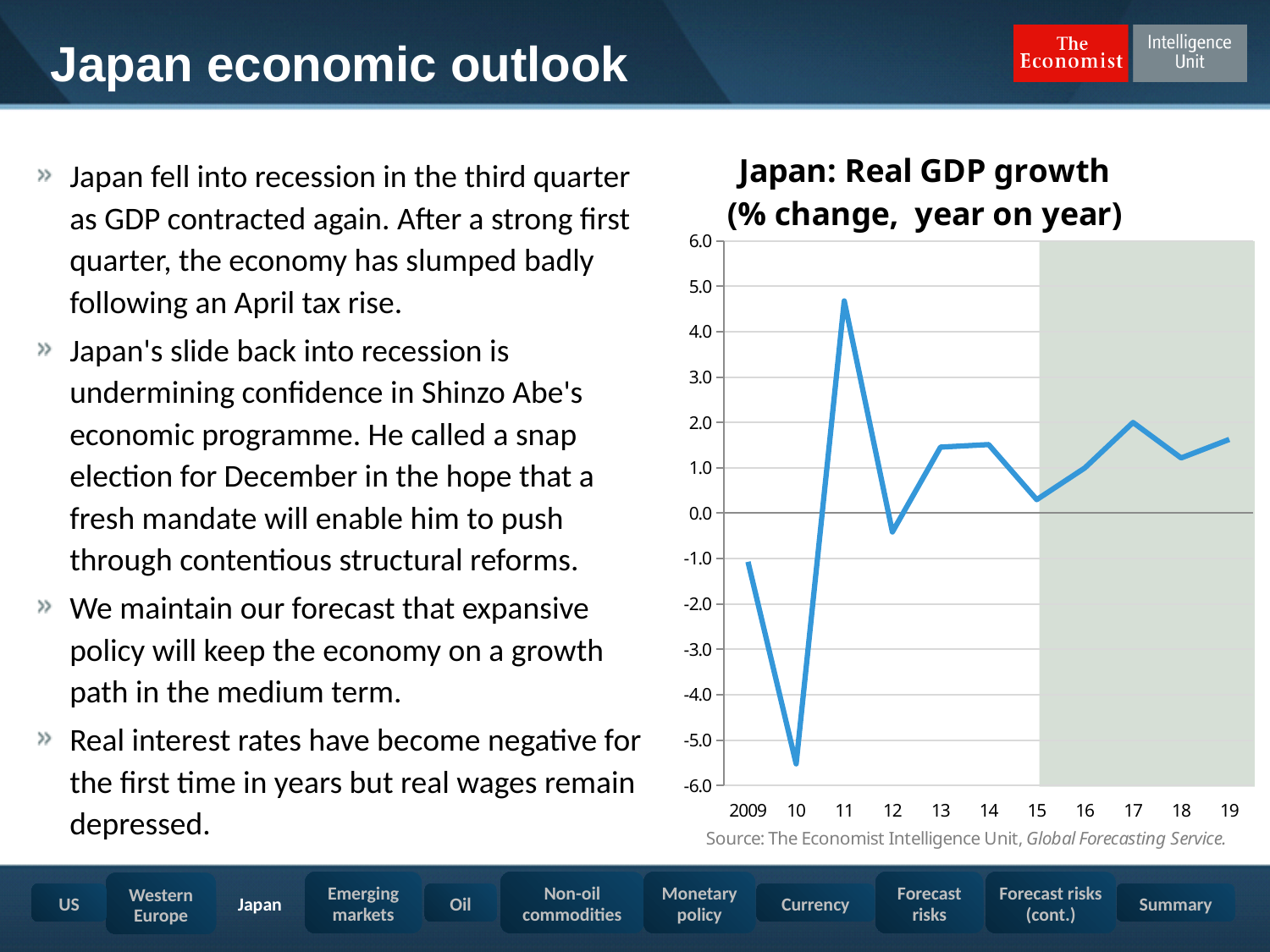
Is the value for 2012 greater or less than 0.0? less In which year is Japan's real GDP growth highest? 2011 In which year is Japan's real GDP growth lowest? 2010 Which year has the larger real GDP growth, 2015 or 2016? 2016 How many years are plotted on the x axis of the chart? 11 Which year has the larger real GDP growth, 2011 or 2017? 2011 Is the value for 2017 greater or less than 1.0? greater What kind of chart is shown on the slide? line chart Does real GDP growth rise or fall from 2015 to 2017? rise Is the value for 2010 greater or less than -5.0? less What is the title of the chart? Japan: Real GDP growth (% change, year on year)